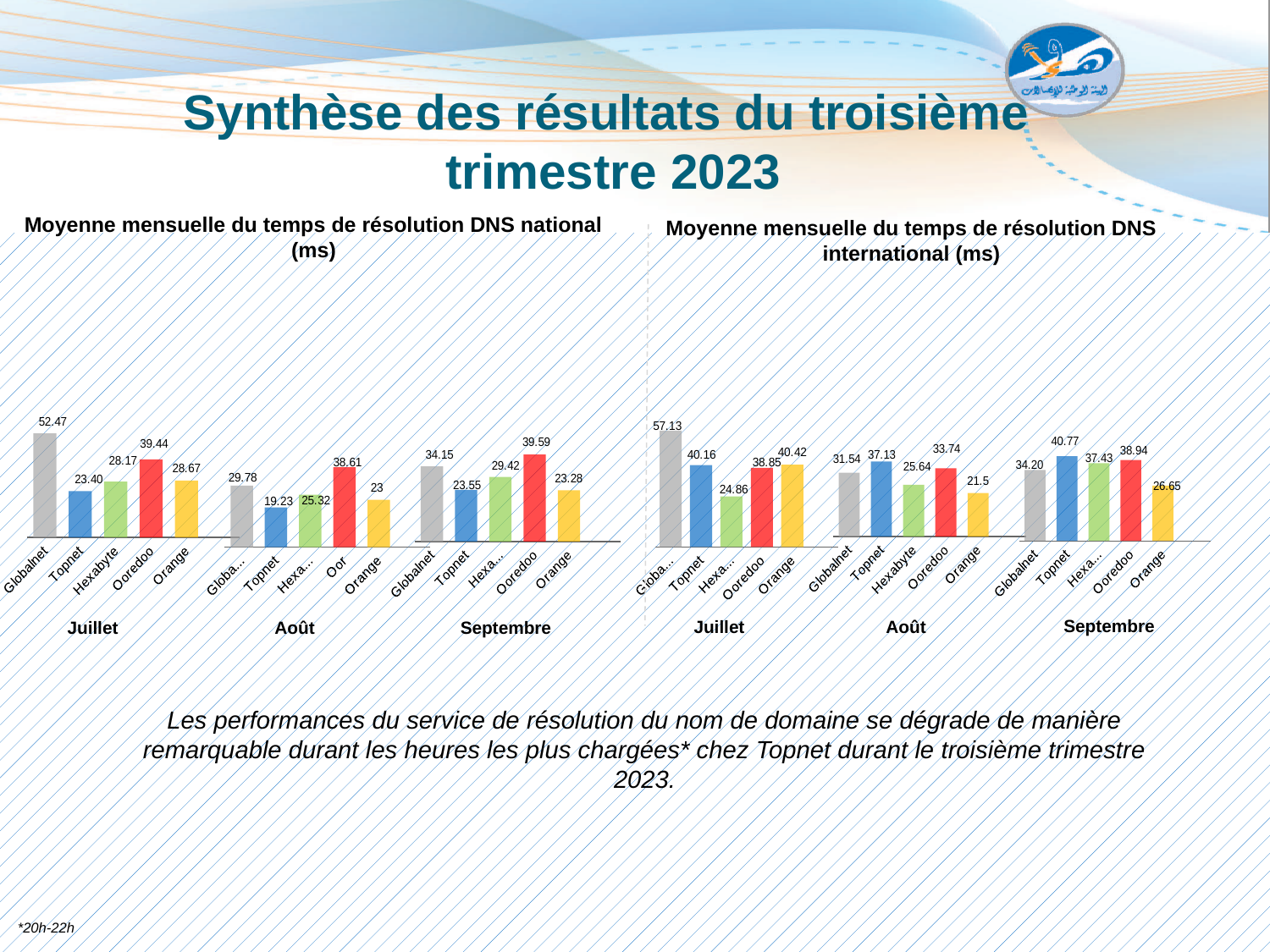
In the national DNS chart (left), which operator has the highest value in Septembre? Ooredoo What type of chart is used for the international DNS resolution time (right)? Bar chart In the international DNS chart (right), which is larger in Août: Topnet or Ooredoo? Topnet In the national DNS chart (left), which operator has the lowest value in Août? Topnet In the international DNS chart (right), which operator has the highest value in Septembre? Topnet In the national DNS chart (left), what is the value for Globalnet in Juillet? 52.47 In the national DNS chart (left), what is the difference between Globalnet and Topnet in Juillet? 29.07 In the international DNS chart (right), what is the value for Globalnet in Juillet? 57.13 In the international DNS chart (right), what is the difference between Topnet in Septembre and Topnet in Août? 3.64 How many months are shown in the national DNS chart (left)? 3 In the national DNS chart (left), what is the value for Ooredoo in Août? 38.61 In the international DNS chart (right), what is the value for Orange in Août? 21.5